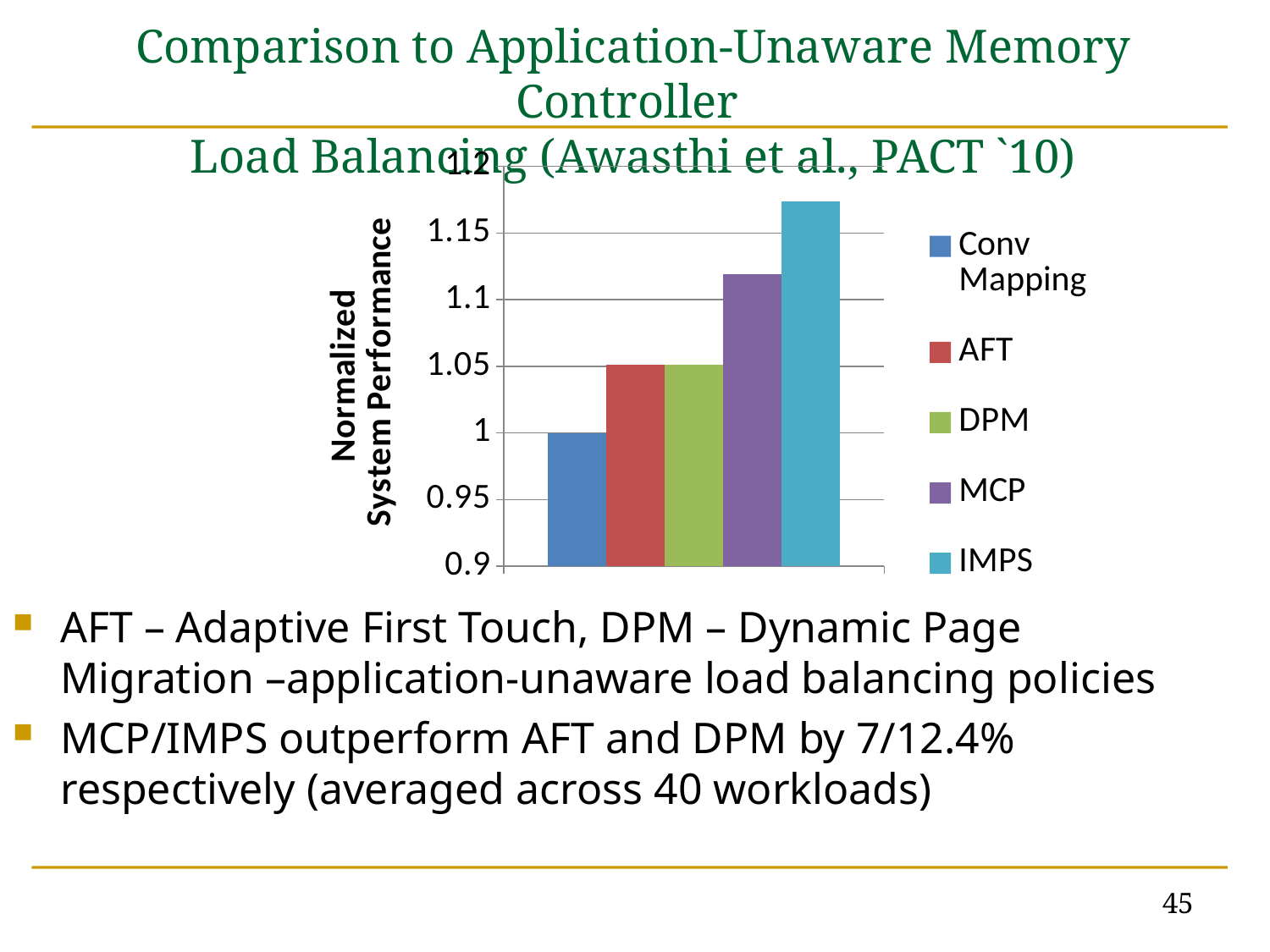
Which has a higher normalized system performance, IMPS or MCP? IMPS What kind of chart is shown on the slide? bar chart How many series does the legend list? 5 Is the value for IMPS greater or less than 1.15? greater Is the value for AFT greater or less than 1.1? less What is the title of the vertical axis? Normalized System Performance Which series has the highest normalized system performance? IMPS What is the normalized system performance for Conv Mapping? 1 Is the value for MCP greater or less than 1.1? greater Which has a higher normalized system performance, MCP or AFT? MCP Which series has the lowest normalized system performance? Conv Mapping